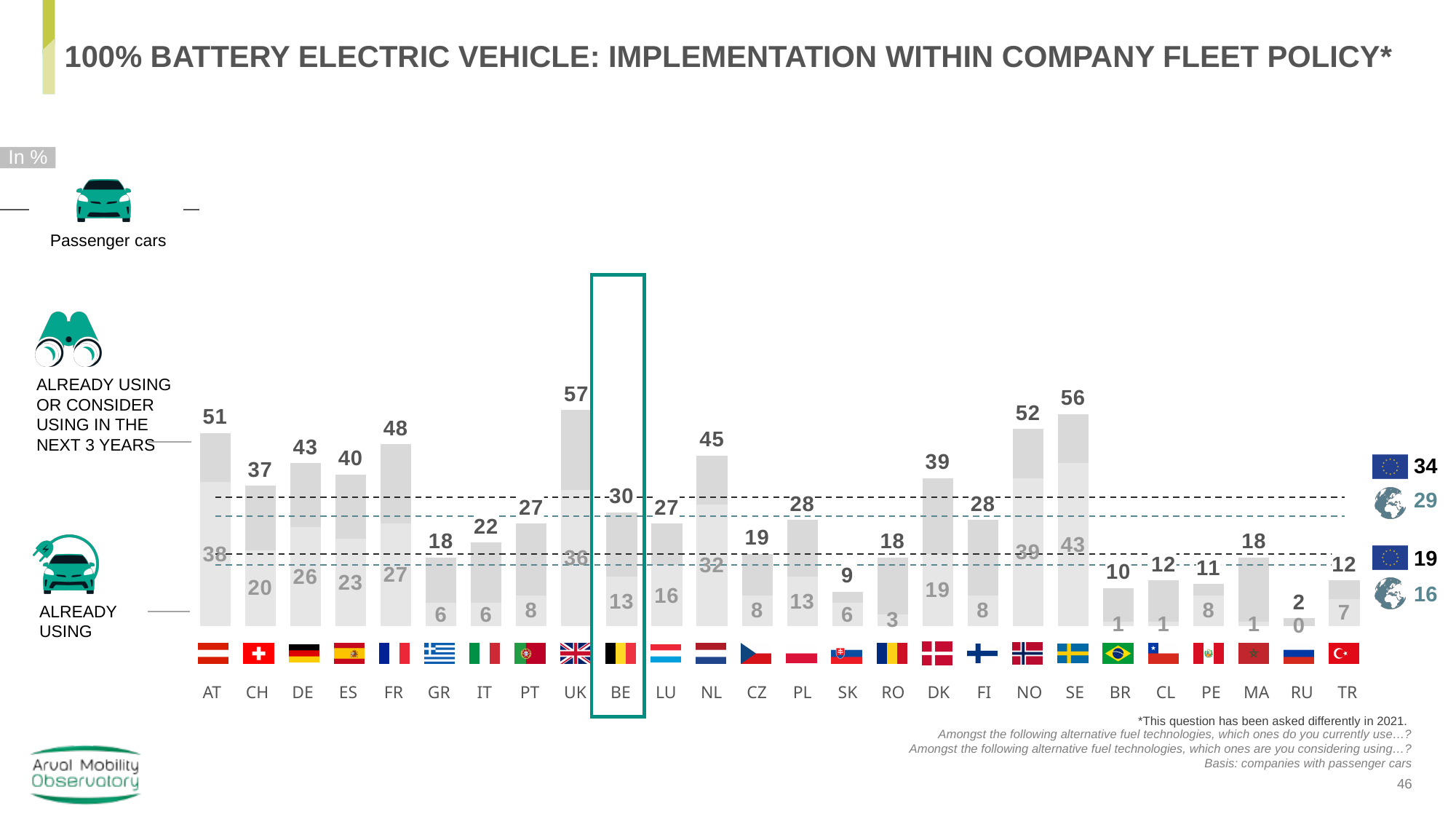
What is the 'already using' value for BE? 13 What kind of chart is shown on the slide? Bar chart What is the 'already using' value for SE? 43 How many countries are shown on the x axis? 26 Which country has the lowest 'already using or consider using in the next 3 years' value? RU Which has a higher 'already using' value, NL or FR? NL What is the 'already using or consider using in the next 3 years' value for UK? 57 Which country has the highest 'already using or consider using in the next 3 years' value? UK What is the EU average for 'already using or consider using in the next 3 years' shown at the right of the chart? 34 What is the global average for 'already using' shown at the right of the chart? 16 Which country has the highest 'already using' value? SE What is the difference between the 'already using or consider using' values for NO and DK? 13